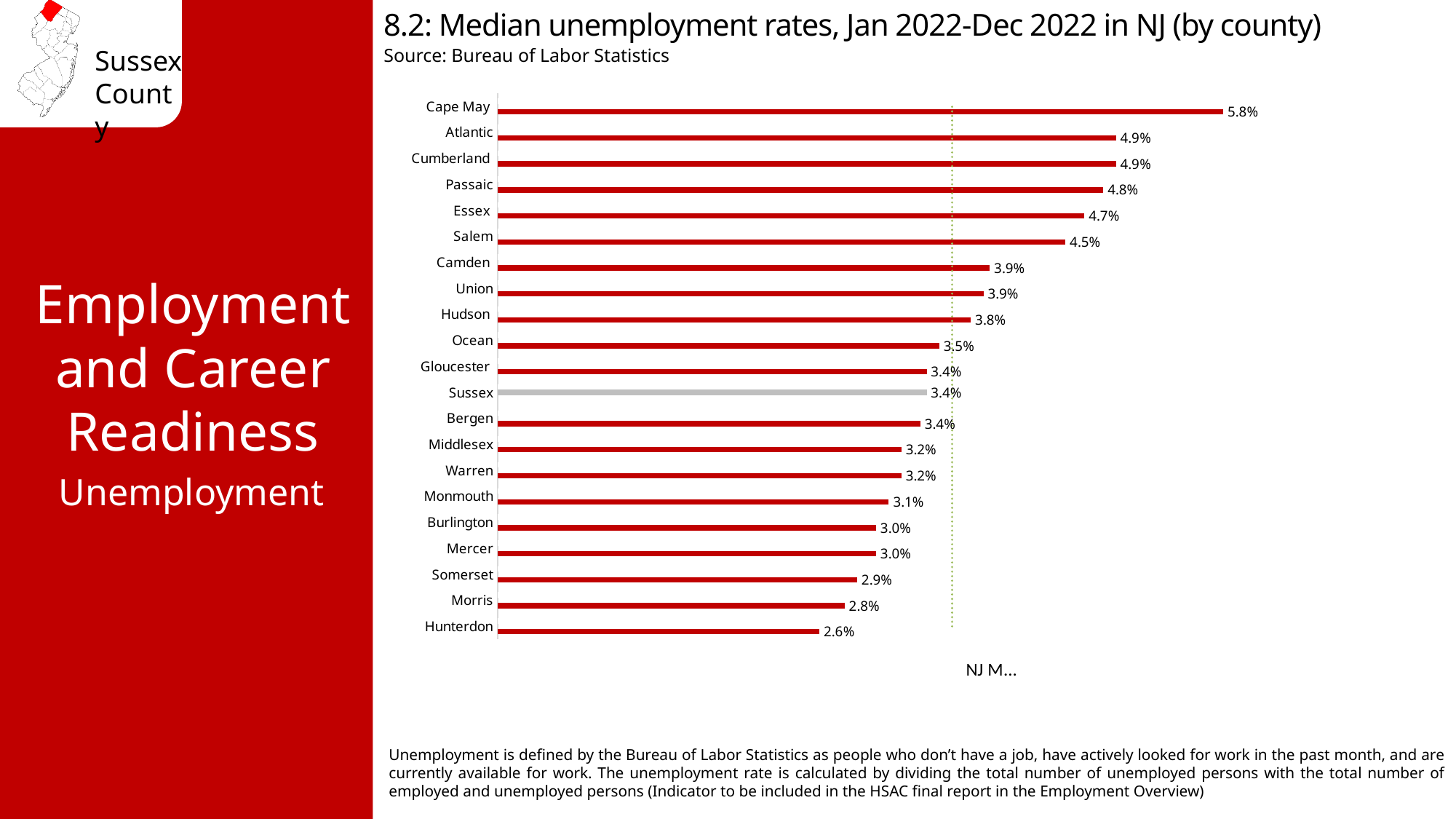
How many counties are shown in the chart? 21 Which county has the highest median unemployment rate? Cape May What is the median unemployment rate for Sussex County? 3.4% What is the median unemployment rate for Hunterdon? 2.6% What is the median unemployment rate for Salem? 4.5% Which county has a higher median unemployment rate, Essex or Camden? Essex What is the difference between the median unemployment rates of Cape May and Hunterdon? 3.2% What is the median unemployment rate for Cape May? 5.8% What is the difference between the median unemployment rates of Passaic and Sussex? 1.4% What kind of chart is used to show the median unemployment rates? Bar chart Which county's bar is shown in grey rather than red? Sussex Which county has the lowest median unemployment rate? Hunterdon